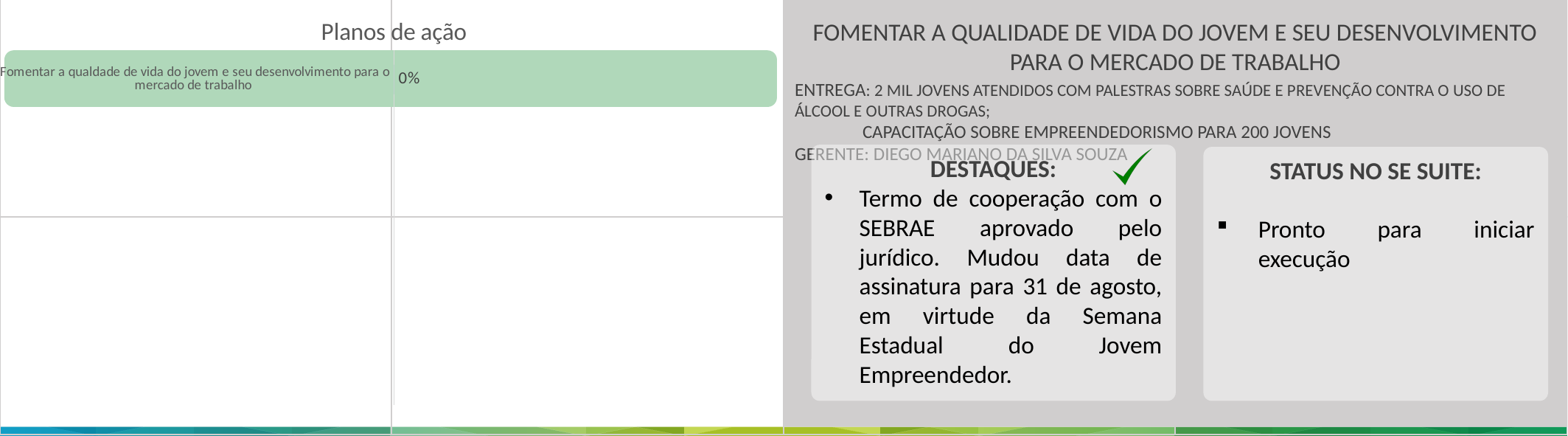
What is the title of the chart on the left of the slide? Planos de ação What kind of chart is shown under the title "Planos de ação"? bar chart In the "Planos de ação" chart, what value is shown for "Fomentar a qualdade de vida do jovem e seu desenvolvimento para o mercado de trabalho"? 0% How many categories does the "Planos de ação" chart show? 1 What is the label of the only category in the "Planos de ação" chart? Fomentar a qualdade de vida do jovem e seu desenvolvimento para o mercado de trabalho